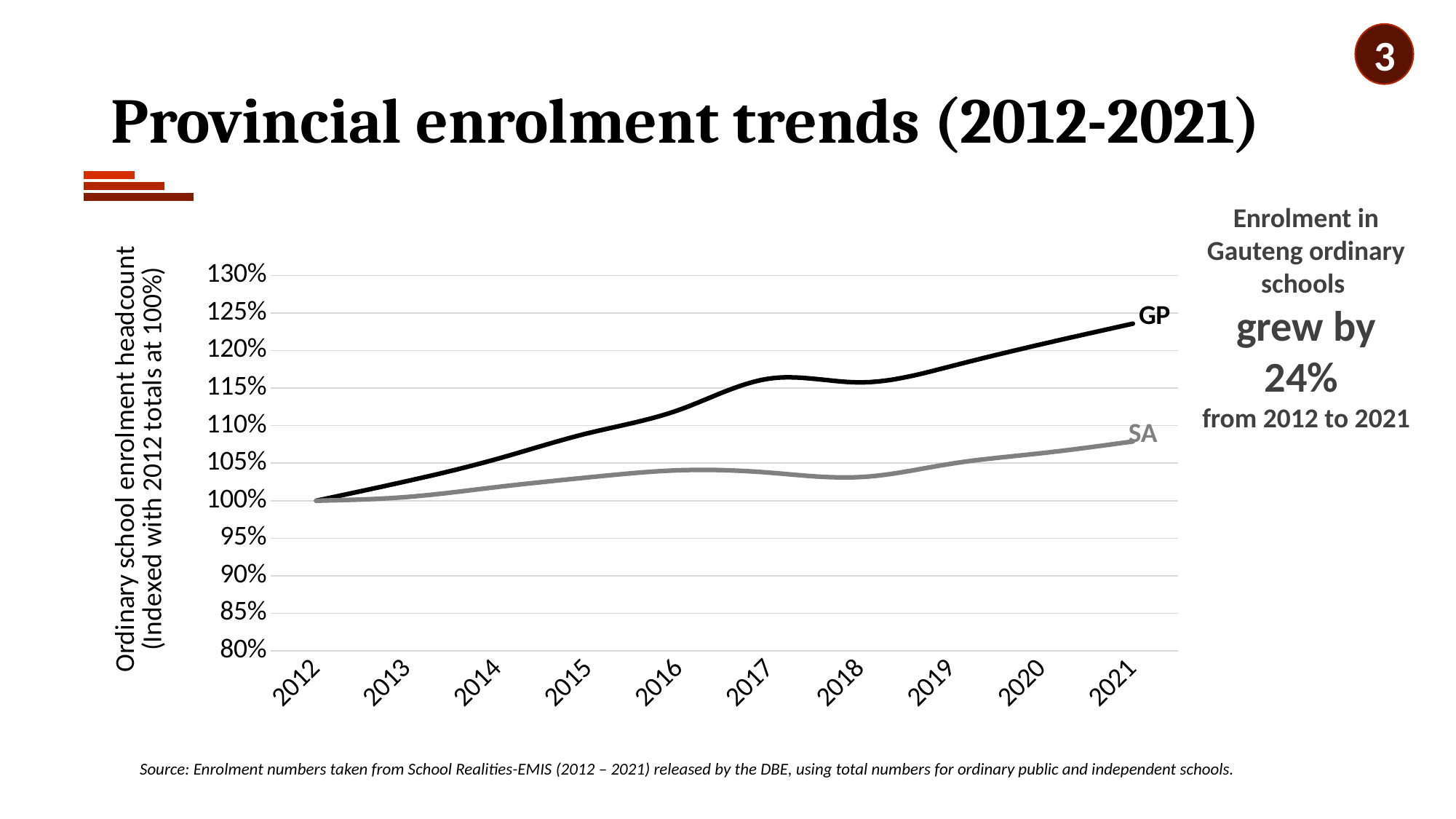
How many series are plotted on the chart? 2 Is the value for SA in 2021 greater or less than 110%? less What is the indexed enrolment value for GP in 2012? 100% Is the value for SA in 2016 greater or less than 105%? less What does the y axis of the chart measure? Ordinary school enrolment headcount (Indexed with 2012 totals at 100%) Is the value for GP in 2021 greater or less than 120%? greater Does the GP line generally rise or fall from 2012 to 2021? rise Which series has the higher value in 2021, GP or SA? GP How many years are shown along the x axis of the chart? 10 What is the indexed enrolment value for SA in 2012? 100% What kind of chart is shown on the slide? line chart